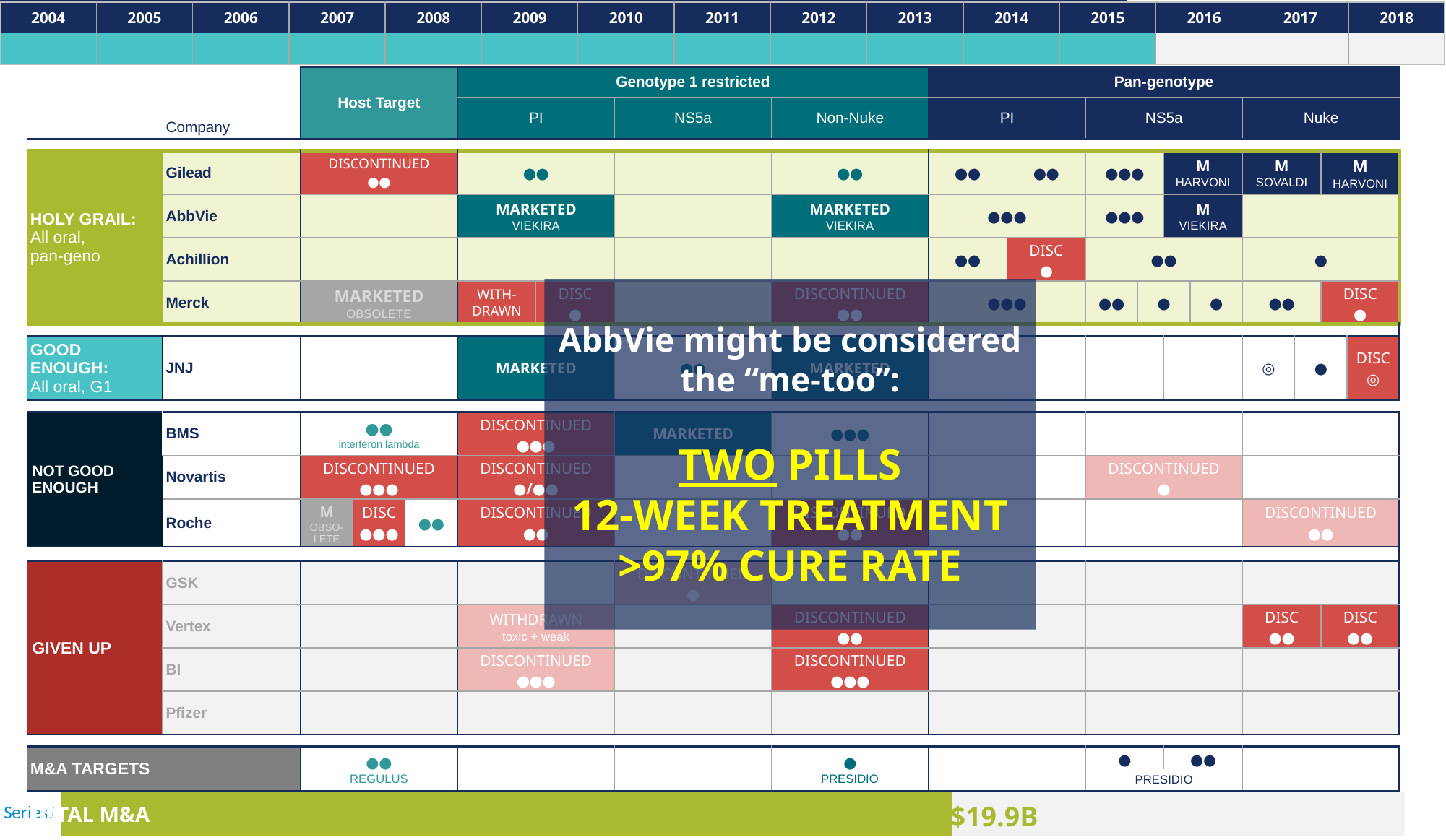
What kind of chart is the TOTAL M&A graphic at the bottom of the slide? bar chart In the bar at the bottom of the slide, what value is printed for TOTAL M&A? $19.9B What colour is the TOTAL M&A bar at the bottom of the slide? green